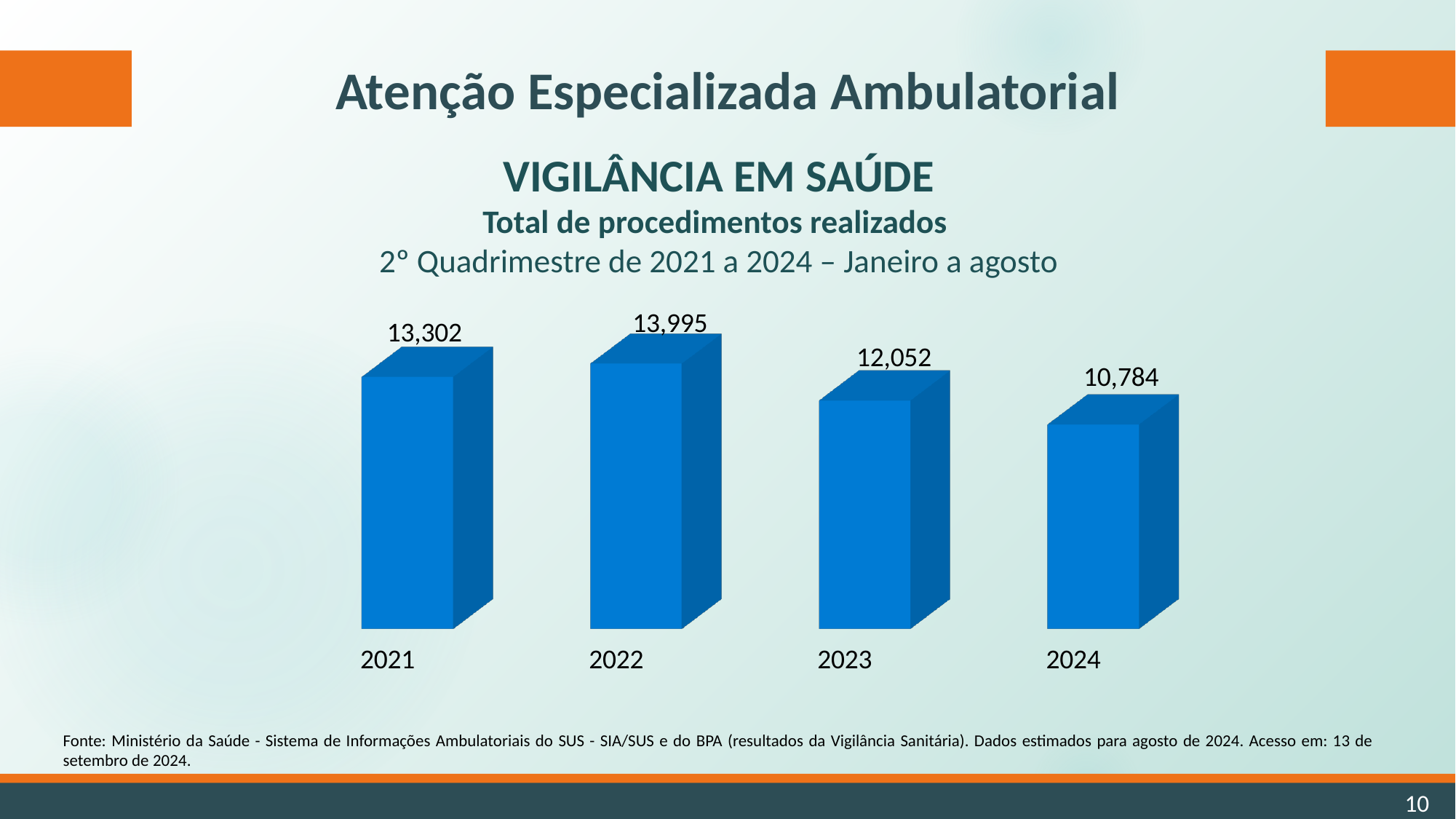
Do the values rise or fall from 2022 to 2024? Fall What is the difference between the values for 2022 and 2024? 3,211 Which year has the highest number of procedures? 2022 Which year has a larger value, 2021 or 2023? 2021 What is the total number of procedures shown for 2023? 12,052 What is the total number of procedures shown for 2021? 13,302 What is the total number of procedures shown for 2022? 13,995 What is the total number of procedures shown for 2024? 10,784 What kind of chart is shown on the slide? Bar chart Which year has the lowest number of procedures? 2024 How many years are shown in the chart? 4 What is the difference between the values for 2021 and 2023? 1,250